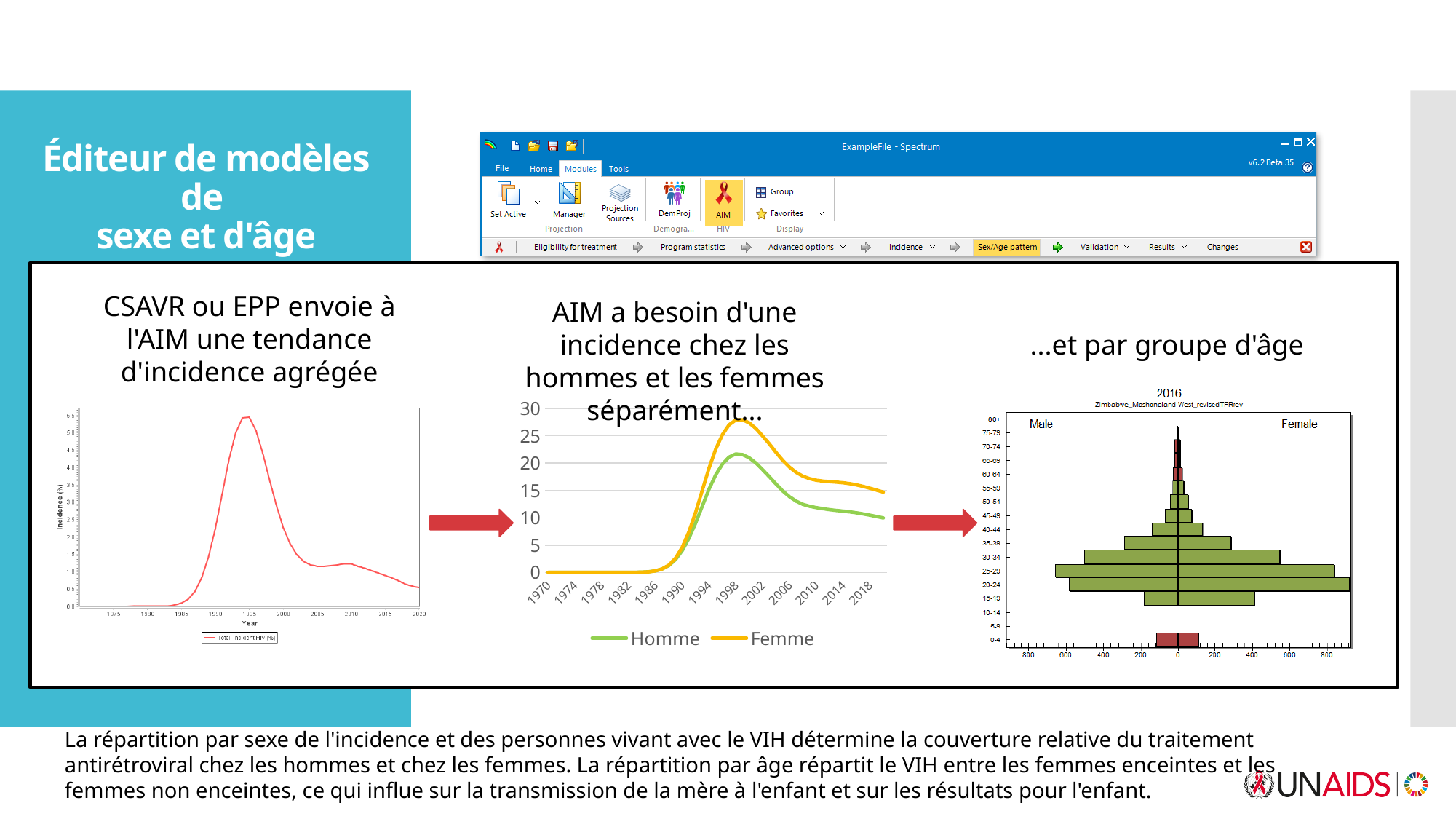
In the middle chart, is the value of the Homme line in 2018 greater or less than 15? less In the middle chart, is the peak value of the Femme line greater or less than 25? greater In the middle chart, which series has the higher value in 2010, Homme or Femme? Femme How many series does the legend of the middle chart list? 2 What kind of chart is the middle chart with the Homme and Femme lines? line chart In the right chart titled 2016, is the Female value for the 20-24 age group greater or less than 800? greater What kind of chart is the right chart titled 2016? bar chart How many age groups are shown on the right chart titled 2016? 17 What kind of chart is the left chart showing Total: Incident HIV (%)? line chart What is the label of the y axis of the left chart? Incidence (%) In the middle chart, do the Homme and Femme lines rise or fall between 1986 and 1998? rise